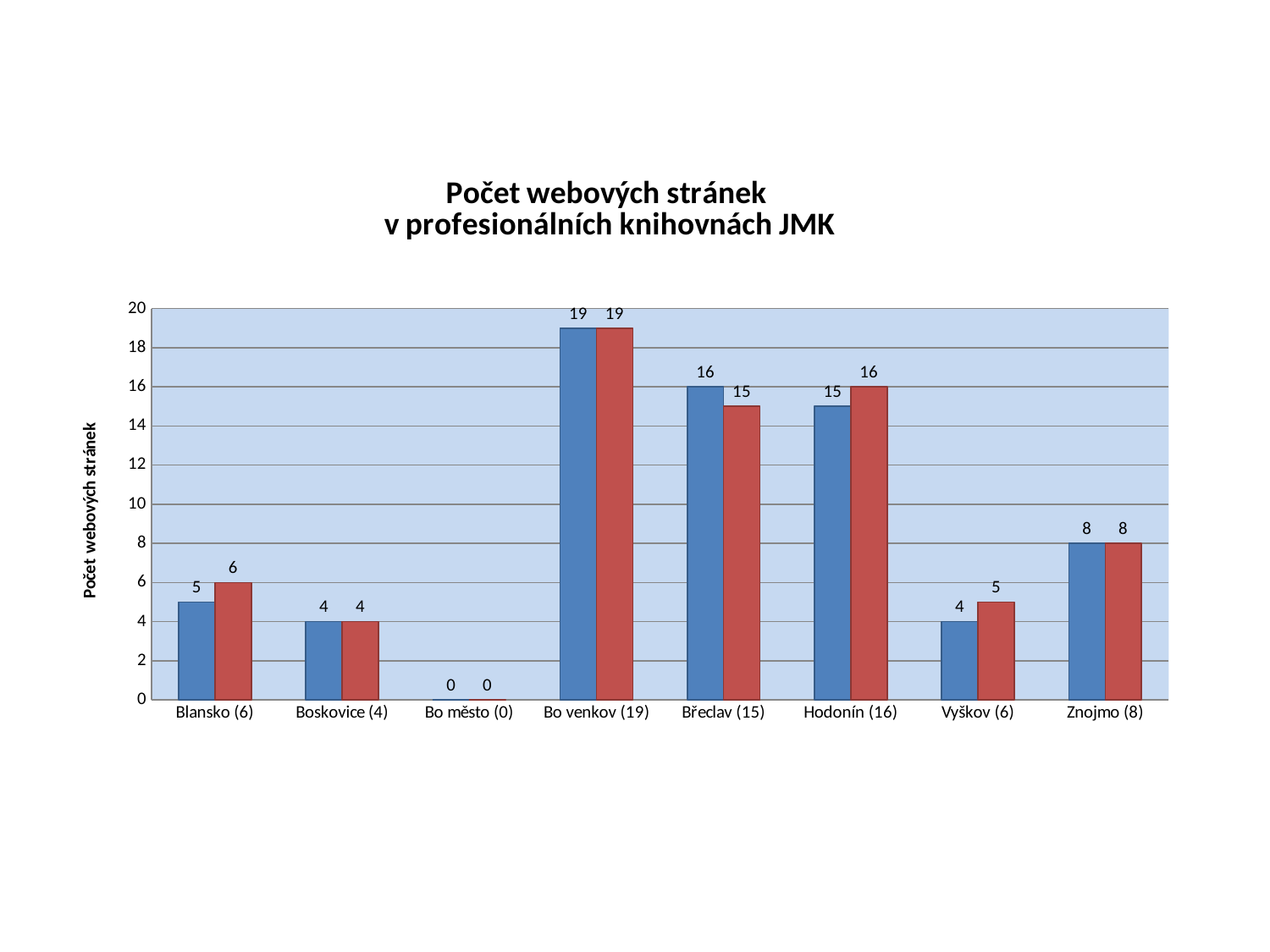
What is the value of the blue bar for Blansko (6)? 5 Which is larger for Hodonín (16), the blue bar or the red bar? the red bar Which category has the highest bars in the chart? Bo venkov (19) Is the value of the blue bar for Znojmo (8) greater or less than 10? less How many categories are shown on the x axis? 8 What is the label of the vertical axis? Počet webových stránek Which category has the lowest bars in the chart? Bo město (0) What is the value of the red bar for Břeclav (15)? 15 What kind of chart is shown on the slide? bar chart What is the value of the red bar for Hodonín (16)? 16 What is the difference between the red bar and the blue bar for Vyškov (6)? 1 What is the title of the chart? Počet webových stránek v profesionálních knihovnách JMK